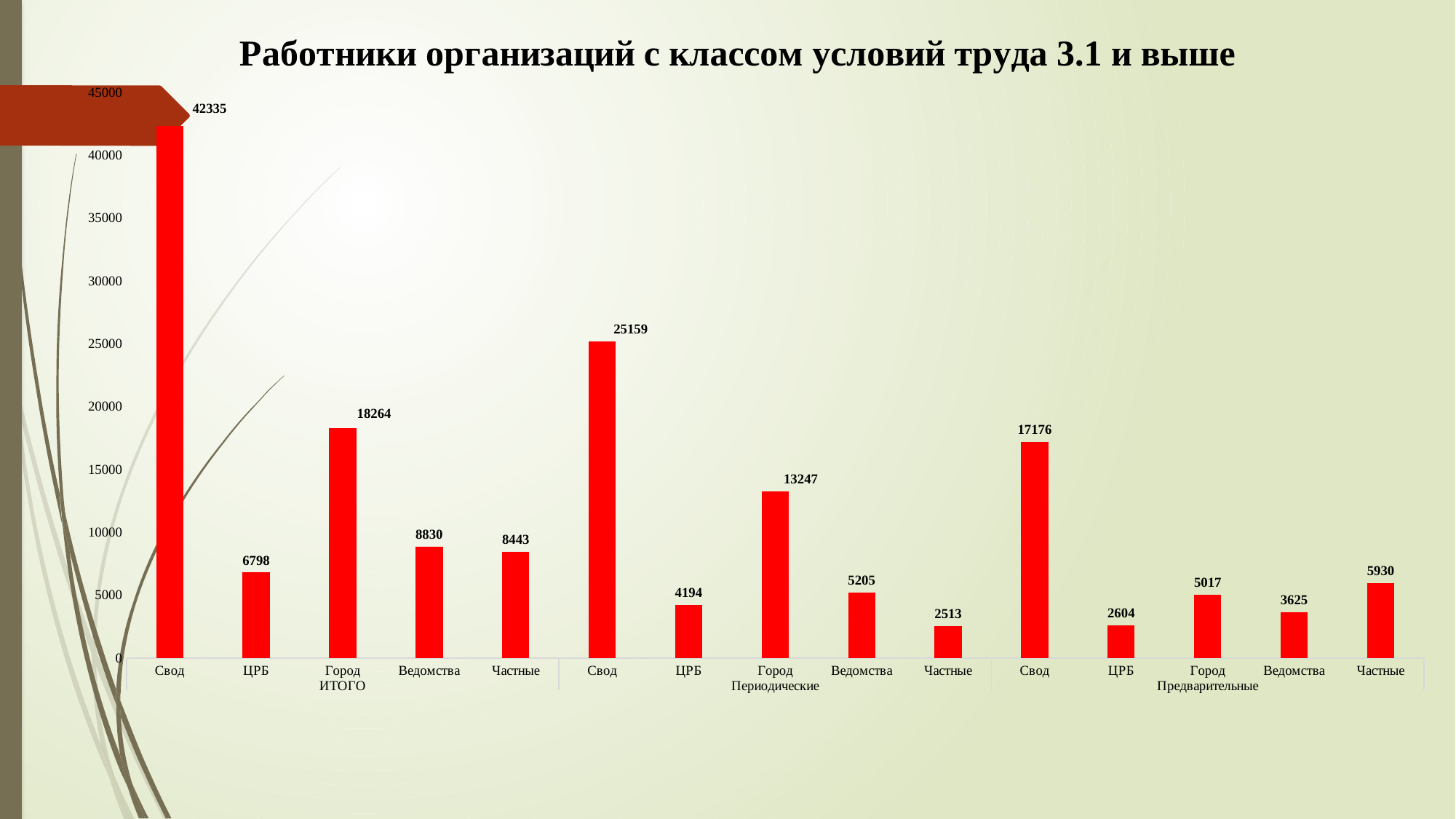
What is the title of the chart? Работники организаций с классом условий труда 3.1 и выше What is the value for Город in the Периодические group? 13247 Which bar has the highest value on the chart? Свод (ИТОГО) What is the value for Частные in the Периодические group? 2513 What is the difference between Свод in the Периодические group and Свод in the Предварительные group? 7983 What kind of chart is shown on the slide? bar chart Which is larger: Ведомства in the ИТОГО group or Частные in the ИТОГО group? Ведомства Is the value for Город in the ИТОГО group greater or less than 20000? less What is the value for Ведомства in the Предварительные group? 3625 What is the value for Свод in the ИТОГО group? 42335 Which bar has the lowest value on the chart? Частные (Периодические) How many bars are plotted on the chart? 15